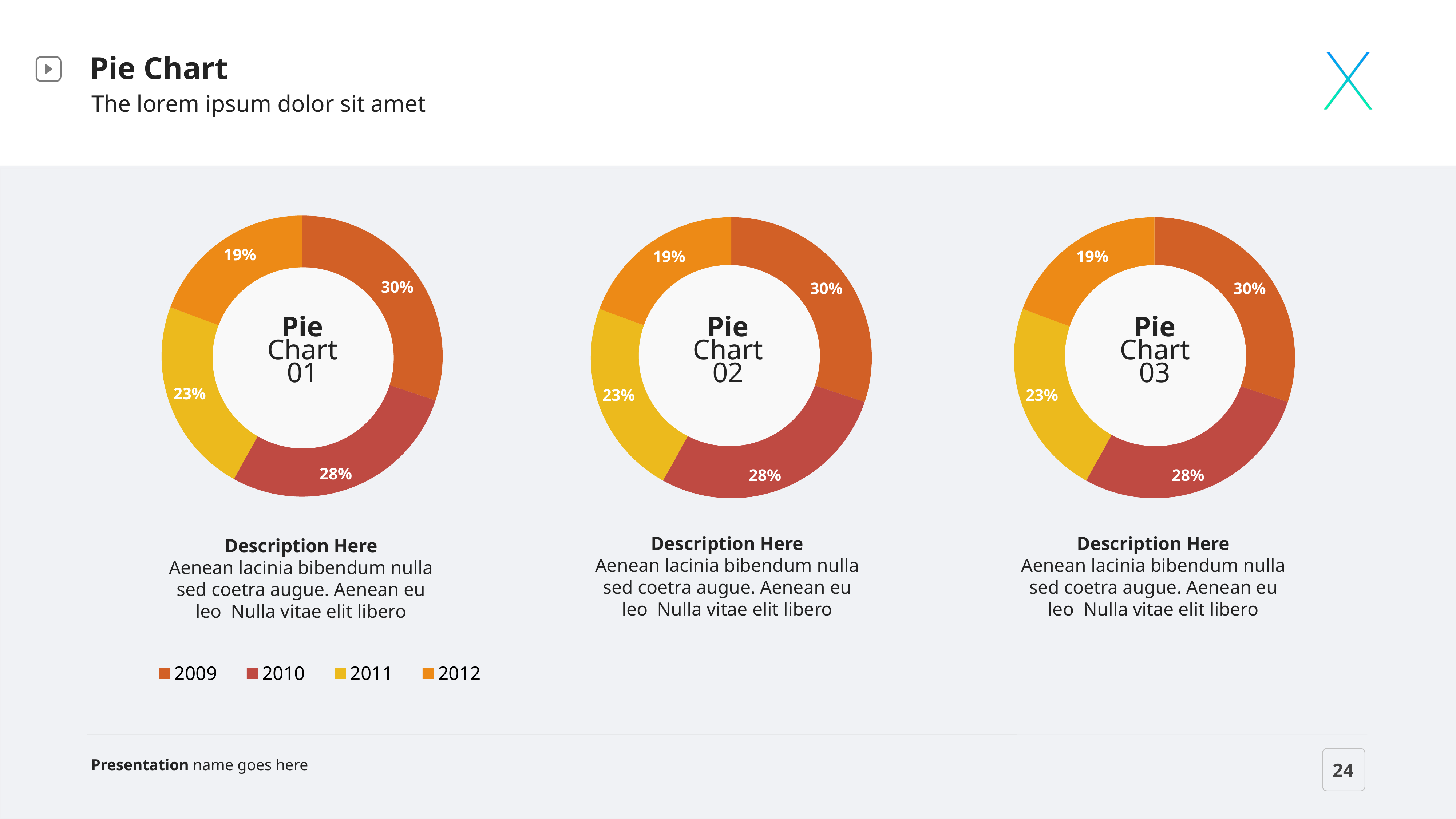
How many pie charts are shown on the slide? 3 What kind of chart is Pie Chart 01? Pie chart In Pie Chart 03, which category has the smallest share? 2012 How many entries does the legend list? 4 In Pie Chart 02, which category has the largest share? 2009 In Pie Chart 02, which is larger, the value for 2010 or the value for 2011? 2010 How many slices does Pie Chart 03 have? 4 In Pie Chart 01, what is the difference between the values for 2009 and 2012? 11% In Pie Chart 02, what is the value for 2011? 23% In Pie Chart 01, what is the value for 2010? 28% In Pie Chart 03, what is the value for 2012? 19% In Pie Chart 01, what is the value for 2009? 30%